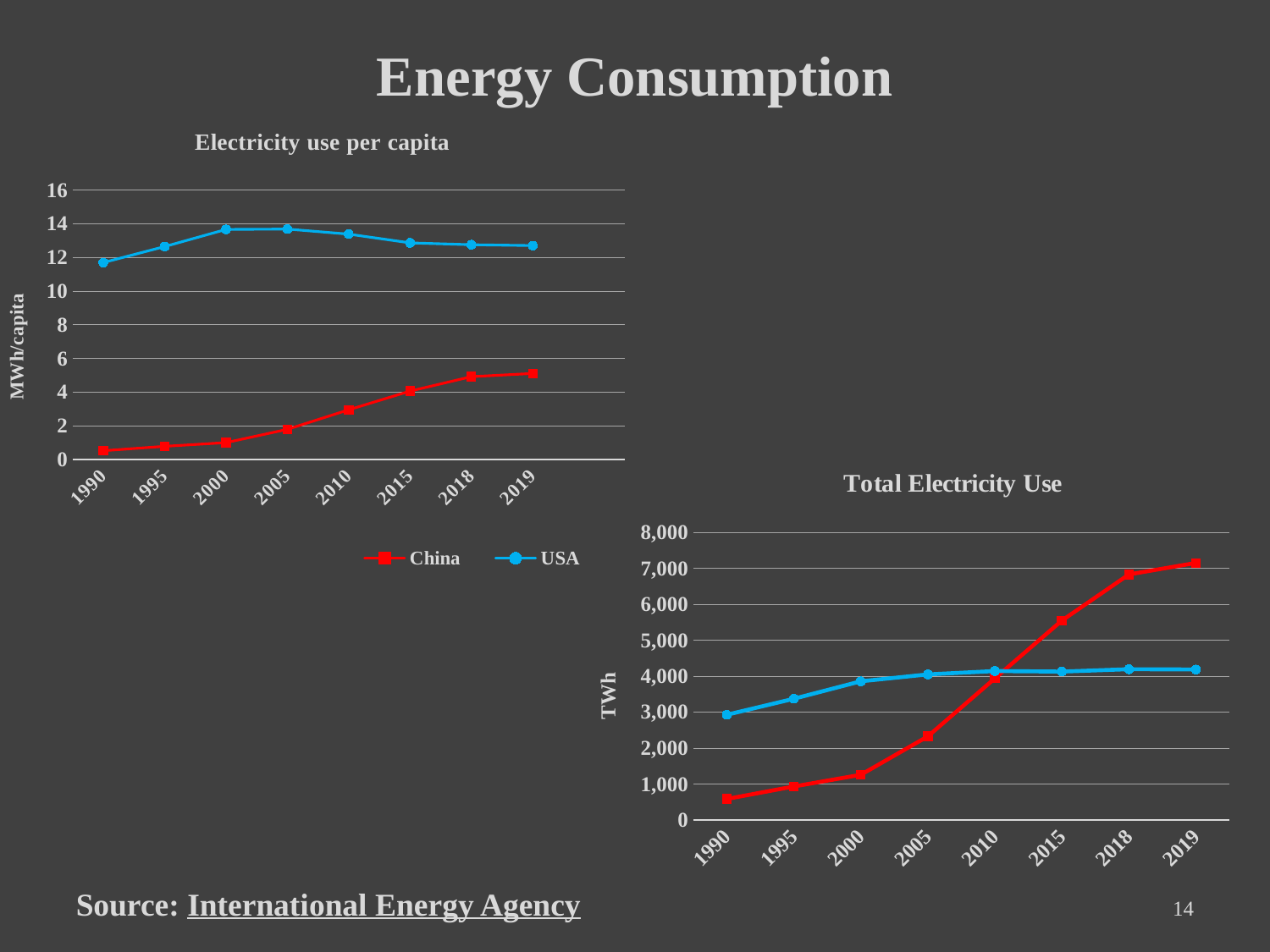
In the 'Total Electricity Use' chart, in which year is the China value highest? 2019 In the 'Electricity use per capita' chart, how many years are plotted along the x axis? 8 In the 'Total Electricity Use' chart, is the value for China in 2005 greater or less than 3,000? less In the 'Electricity use per capita' chart, does the China line rise or fall from 1990 to 2019? rise In the 'Electricity use per capita' chart, is the value for China in 2019 greater or less than 4? greater In the 'Electricity use per capita' chart, which series has the higher value in 2019, China or USA? USA What is the y-axis label of the 'Total Electricity Use' chart? TWh In the 'Electricity use per capita' chart, in which year is the USA value lowest? 1990 In the 'Total Electricity Use' chart, which series has the higher value in 2019, China or USA? China What kind of chart is the 'Electricity use per capita' chart? line chart In the 'Electricity use per capita' chart, is the value for USA in 1990 greater or less than 10? greater